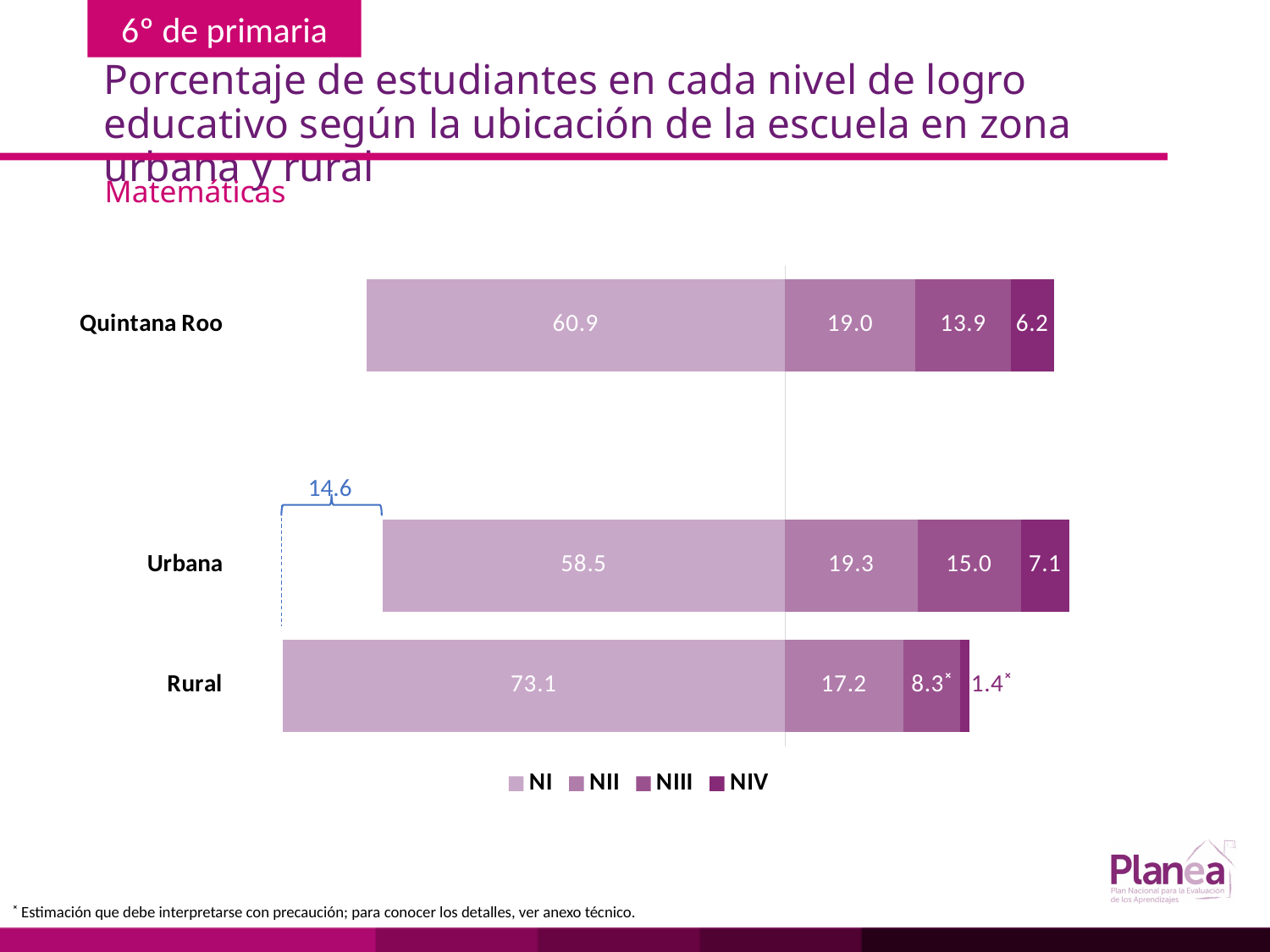
What is the NIII value for Rural? 8.3 What is the difference between the NI values for Rural and Urbana? 14.6 Which category has the lowest NIV value? Rural Which is larger, the NIII value for Urbana or the NIII value for Quintana Roo? Urbana What is the NIV value for Quintana Roo? 6.2 How many categories (bars) are shown in the chart? 3 What is the NII value for Urbana? 19.3 What type of chart is shown on the slide? Stacked bar chart What are the legend entries of the chart, in order? NI, NII, NIII, NIV How many series does the legend list? 4 Which category has the highest NI value? Rural What is the NI value for Rural? 73.1